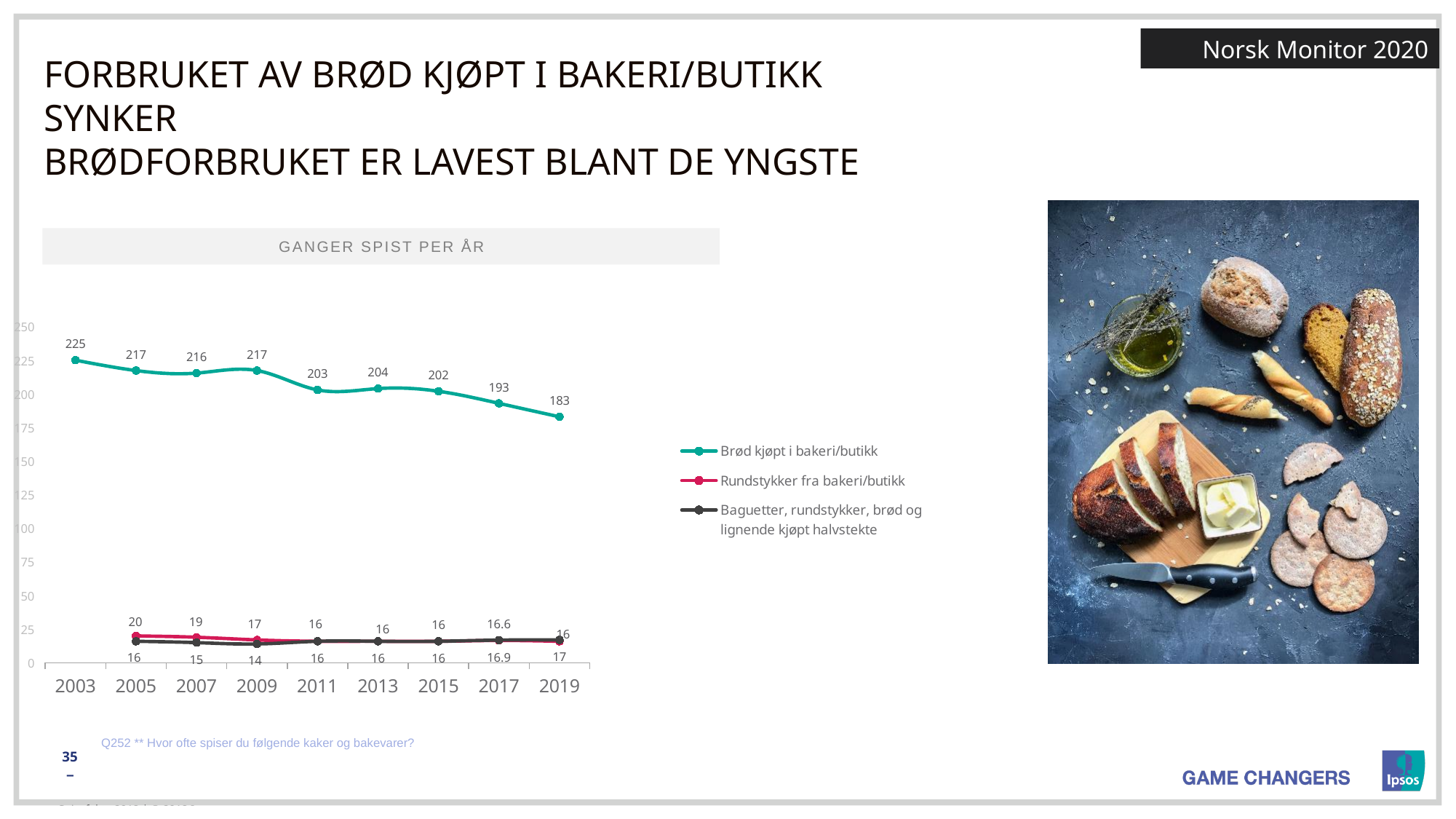
What kind of chart is shown on the slide? line chart In which year is the value for Brød kjøpt i bakeri/butikk lowest? 2019 How many series does the legend list? 3 What is the value for Brød kjøpt i bakeri/butikk in 2019? 183 What is the value for Rundstykker fra bakeri/butikk in 2005? 20 In which year is the value for Brød kjøpt i bakeri/butikk highest? 2003 What is the value for Baguetter, rundstykker, brød og lignende kjøpt halvstekte in 2019? 17 Does the value for Brød kjøpt i bakeri/butikk rise or fall from 2003 to 2019? fall Which year has the larger value for Brød kjøpt i bakeri/butikk, 2009 or 2011? 2009 What is the value for Brød kjøpt i bakeri/butikk in 2003? 225 What is the difference between the 2003 and 2019 values for Brød kjøpt i bakeri/butikk? 42 Is the value for Brød kjøpt i bakeri/butikk in 2015 greater or less than 175? greater